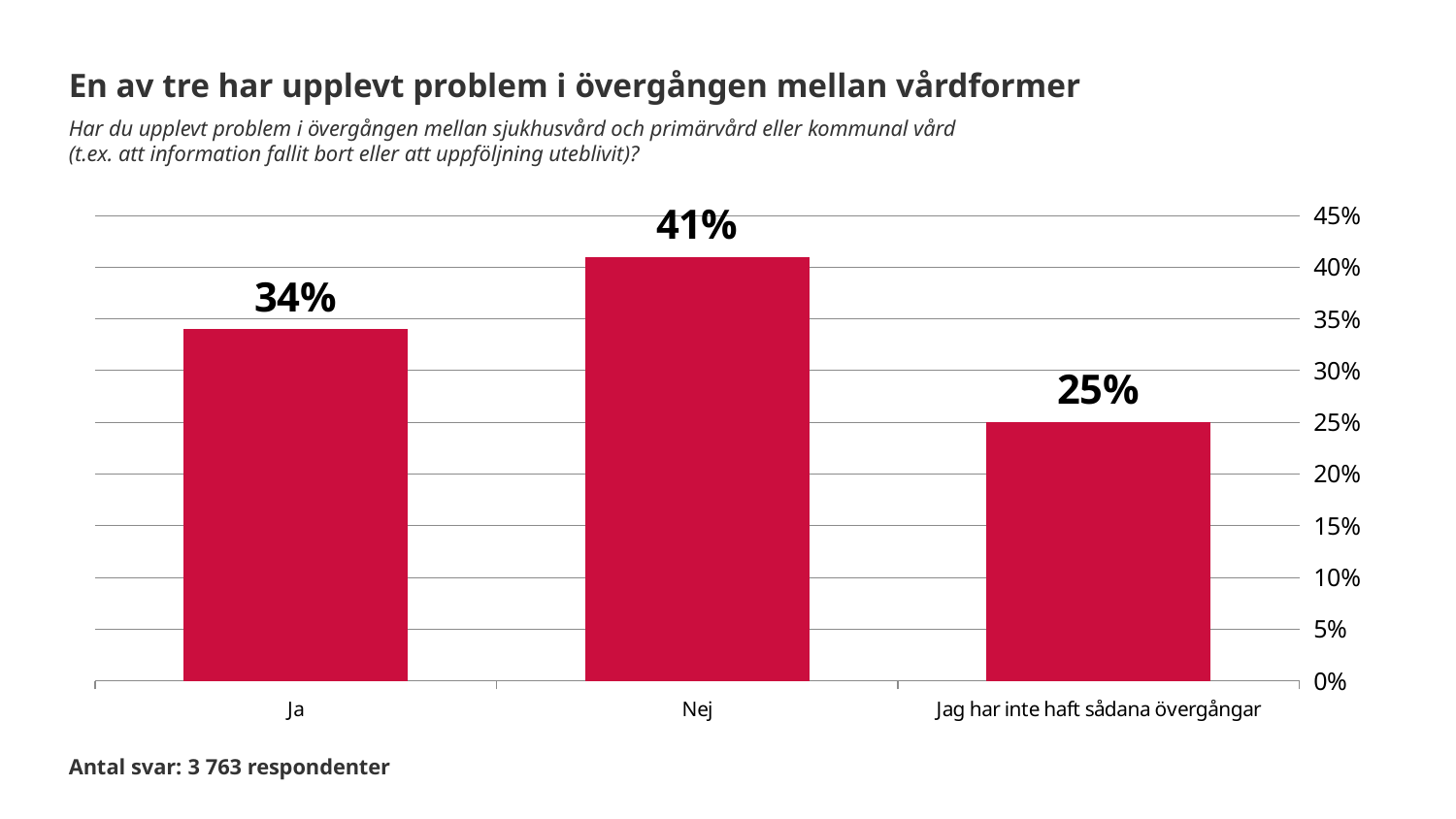
What kind of chart is shown on the slide? bar chart How many categories are shown on the x axis? 3 What is the difference between the values for "Nej" and "Ja"? 7% What is the title of the slide? En av tre har upplevt problem i övergången mellan vårdformer What is the difference between the values for "Ja" and "Jag har inte haft sådana övergångar"? 9% Which category has the lowest value? Jag har inte haft sådana övergångar What is the value for "Nej"? 41% Which is larger, the value for "Ja" or the value for "Nej"? Nej Is the value for "Nej" greater or less than 40%? greater What is the value for "Jag har inte haft sådana övergångar"? 25% Which category has the highest value? Nej What is the value for "Ja"? 34%